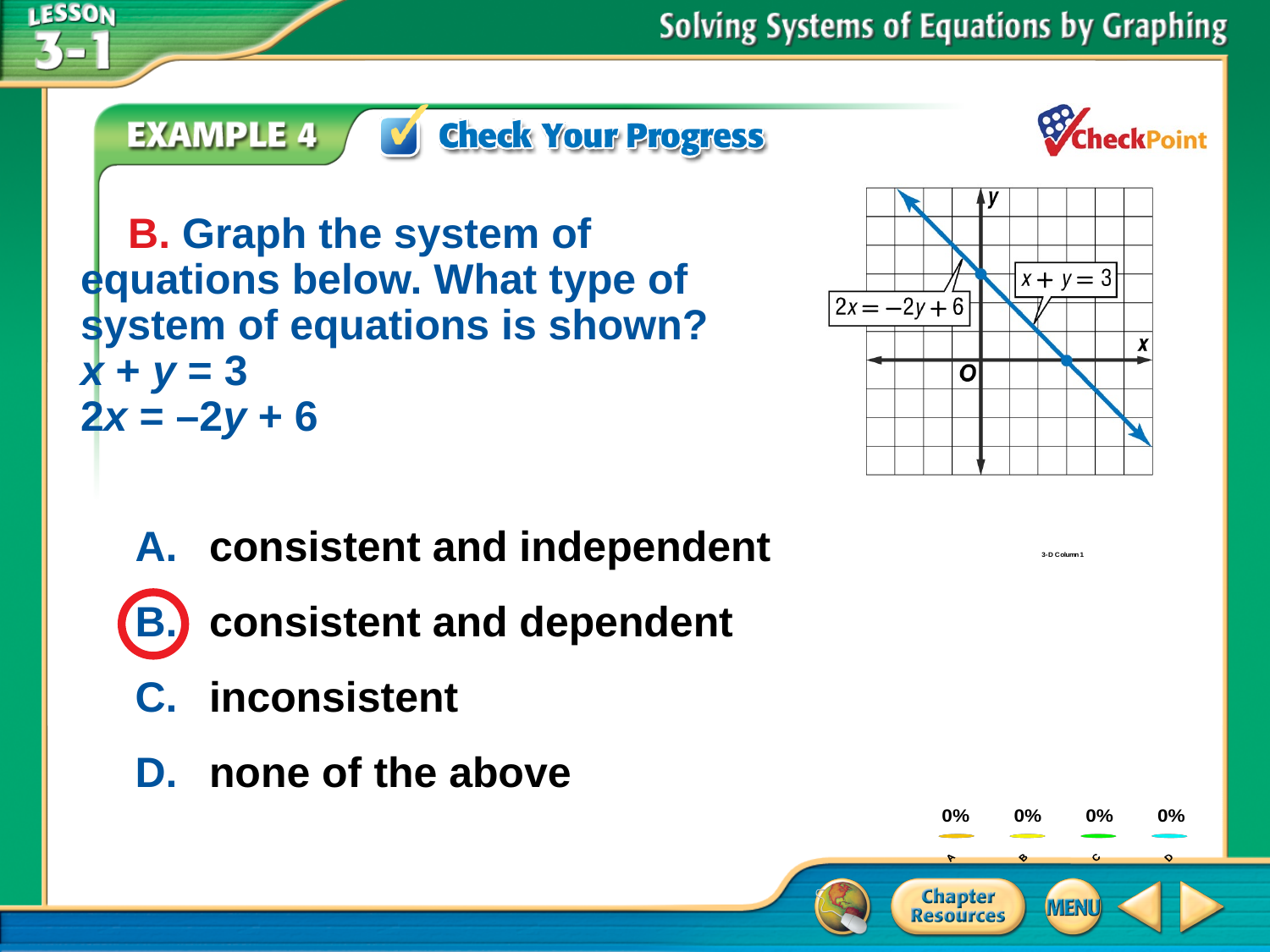
What kind of chart is shown at the bottom right of the slide? bar chart What are the category labels along the x axis of the bar chart at the bottom right of the slide? A, B, C, D In the bar chart at the bottom right of the slide, what is the value shown for category B? 0% What is the title of the small chart at the bottom right of the slide? 3-D Column 1 How many categories does the bar chart at the bottom right of the slide show? 4 In the bar chart at the bottom right of the slide, what is the value shown for category D? 0% In the bar chart at the bottom right of the slide, what is the difference between the values for A and D? 0% In the bar chart at the bottom right of the slide, what is the value shown for category C? 0% In the bar chart at the bottom right of the slide, what is the value shown for category A? 0%